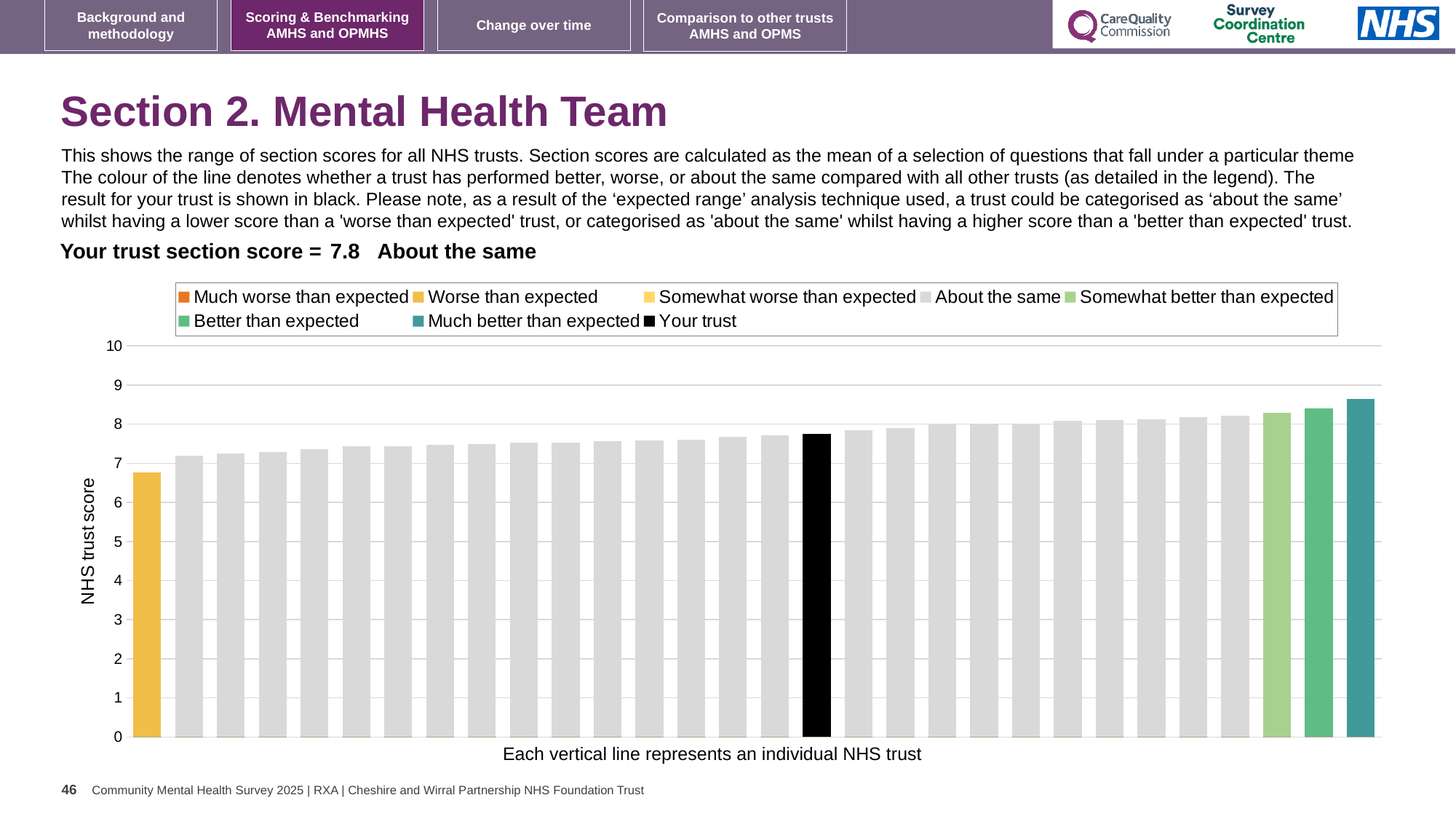
Which legend category does the lowest bar in the chart belong to? Worse than expected Is the value of the rightmost (highest) bar greater or less than 8? greater What is the label on the vertical axis of the chart? NHS trust score What colour is the bar representing your trust? black What kind of chart is shown on the slide? bar chart What is the section score for your trust shown on the slide? 7.8 Is the value of the leftmost (lowest) bar greater or less than 7? less How many entries does the chart legend list? 8 How many bars are coloured as 'Much better than expected'? 1 Is the value for the 'Your trust' bar greater or less than 7? greater Do the bar values rise or fall from left to right across the chart? rise Which legend category does the highest bar in the chart belong to? Much better than expected